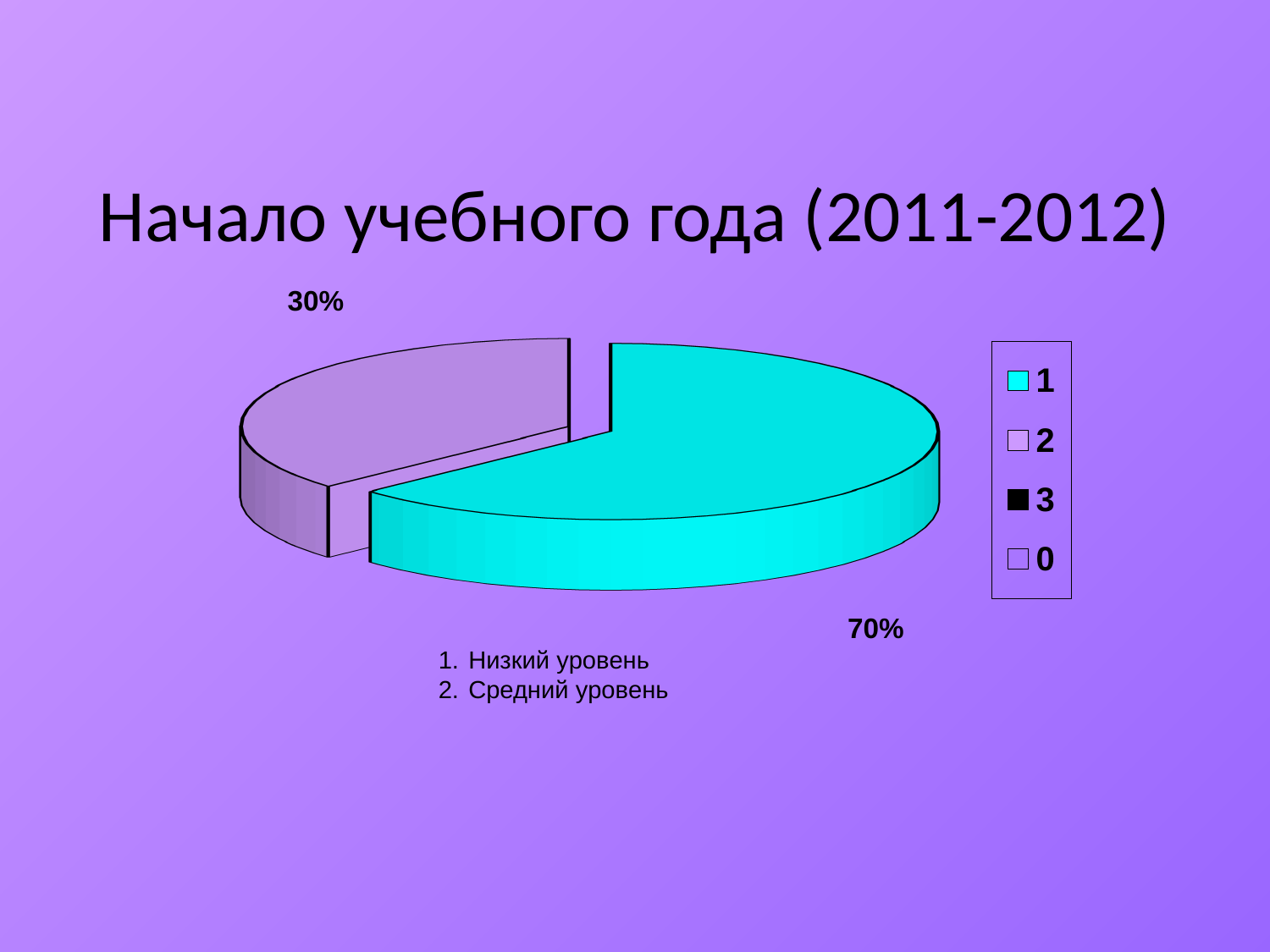
What share of the pie does the cyan slice represent? 70% Which is larger, the share for slice 1 or the share for slice 2? 1 Which slice has the largest share of the pie? 1 How many slices are visible in the pie? 2 What percentage is shown for slice 1 (the cyan slice)? 70% What kind of chart is shown on the slide? pie chart How many entries does the legend list? 4 According to the note below the chart, what does category 1 stand for? Низкий уровень What percentage is shown for slice 2 (the purple slice)? 30% What is the difference in percentage points between slice 1 and slice 2? 40 Which of the visible slices has the smallest share of the pie? 2 What is the title of the chart on the slide? Начало учебного года (2011-2012)